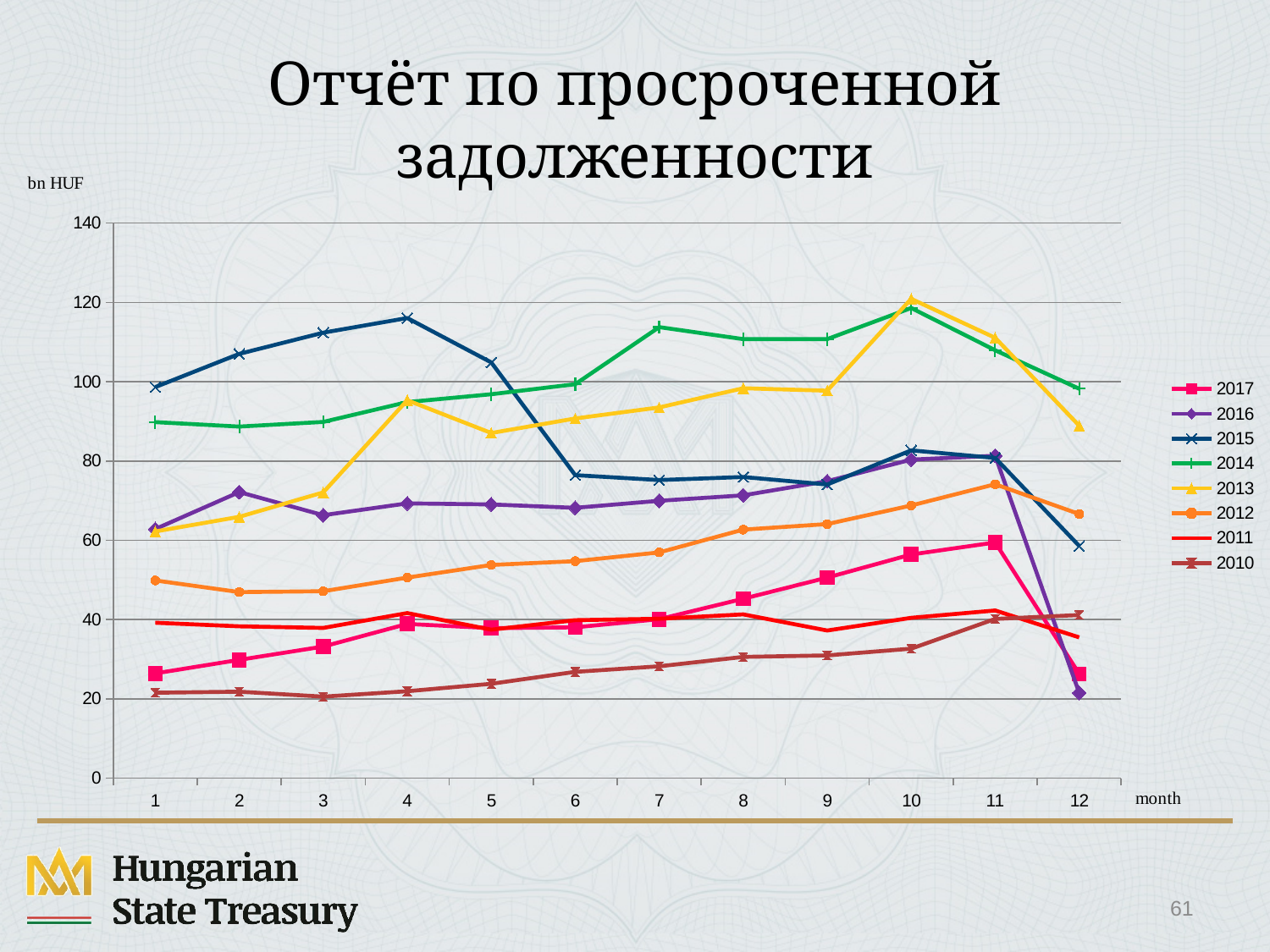
Which series has the highest value in month 4? 2015 In month 11, which is larger: the value for 2017 or the value for 2011? 2017 What unit is shown at the top of the y axis? bn HUF Does the 2010 series rise or fall from month 1 to month 11? rise Is the value for 2015 in month 4 greater or less than 100? greater Which series has the lowest value in month 6? 2010 Is the value for 2010 in month 1 greater or less than 40? less How many months are shown along the x axis? 12 Is the value for 2013 in month 12 greater or less than 80? greater What kind of chart is shown on the slide? line chart How many series does the legend list? 8 In month 6, which is larger: the value for 2014 or the value for 2015? 2014